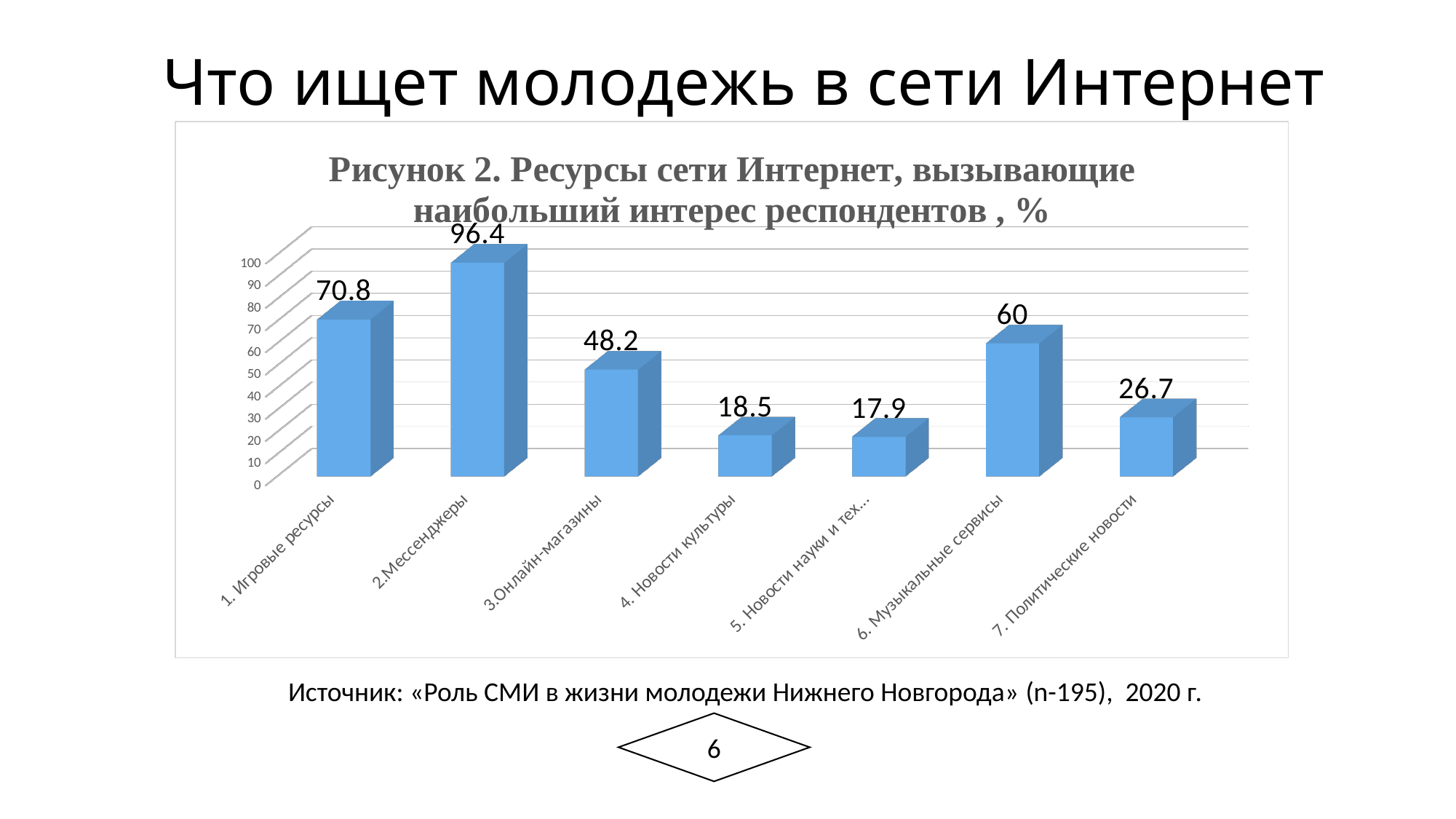
How many categories are shown on the chart? 7 Which is larger, the value for 3.Онлайн-магазины or the value for 6. Музыкальные сервисы? 6. Музыкальные сервисы What is the value for 7. Политические новости? 26.7 What is the value for 2.Мессенджеры? 96.4 What kind of chart is shown on the slide? bar chart What is the difference between the values for 2.Мессенджеры and 1. Игровые ресурсы? 25.6 What is the difference between the values for 6. Музыкальные сервисы and 7. Политические новости? 33.3 What is the value for 1. Игровые ресурсы? 70.8 What is the lowest value shown on the chart? 17.9 Is the value for 4. Новости культуры greater or less than 20? less What is the value for 6. Музыкальные сервисы? 60 Which category has the highest value? 2.Мессенджеры